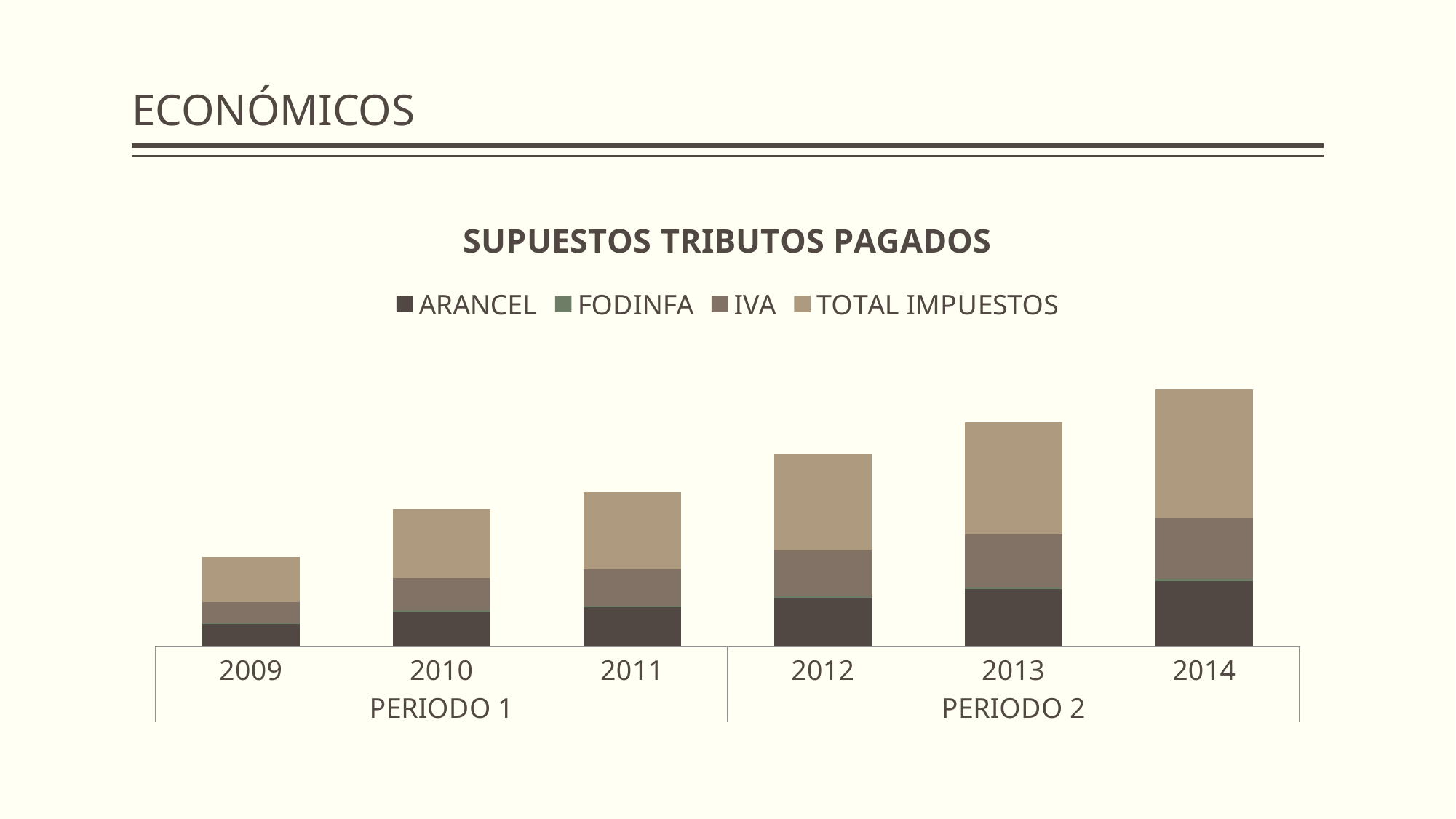
How many years are shown on the x axis? 6 Which series are listed in the legend? ARANCEL, FODINFA, IVA, TOTAL IMPUESTOS What kind of chart is shown on the slide? Stacked bar chart What is the title of the chart? SUPUESTOS TRIBUTOS PAGADOS Which year has the tallest stacked bar? 2014 Which series occupies the bottom segment of each stacked bar? ARANCEL Which year has the shortest stacked bar? 2009 Which years belong to PERIODO 2? 2012, 2013, 2014 Do the stacked bars rise or fall from 2009 to 2014? Rise Which stacked bar is taller, 2012 or 2010? 2012 Which stacked bar is taller, 2009 or 2011? 2011 How many series does the legend list? 4